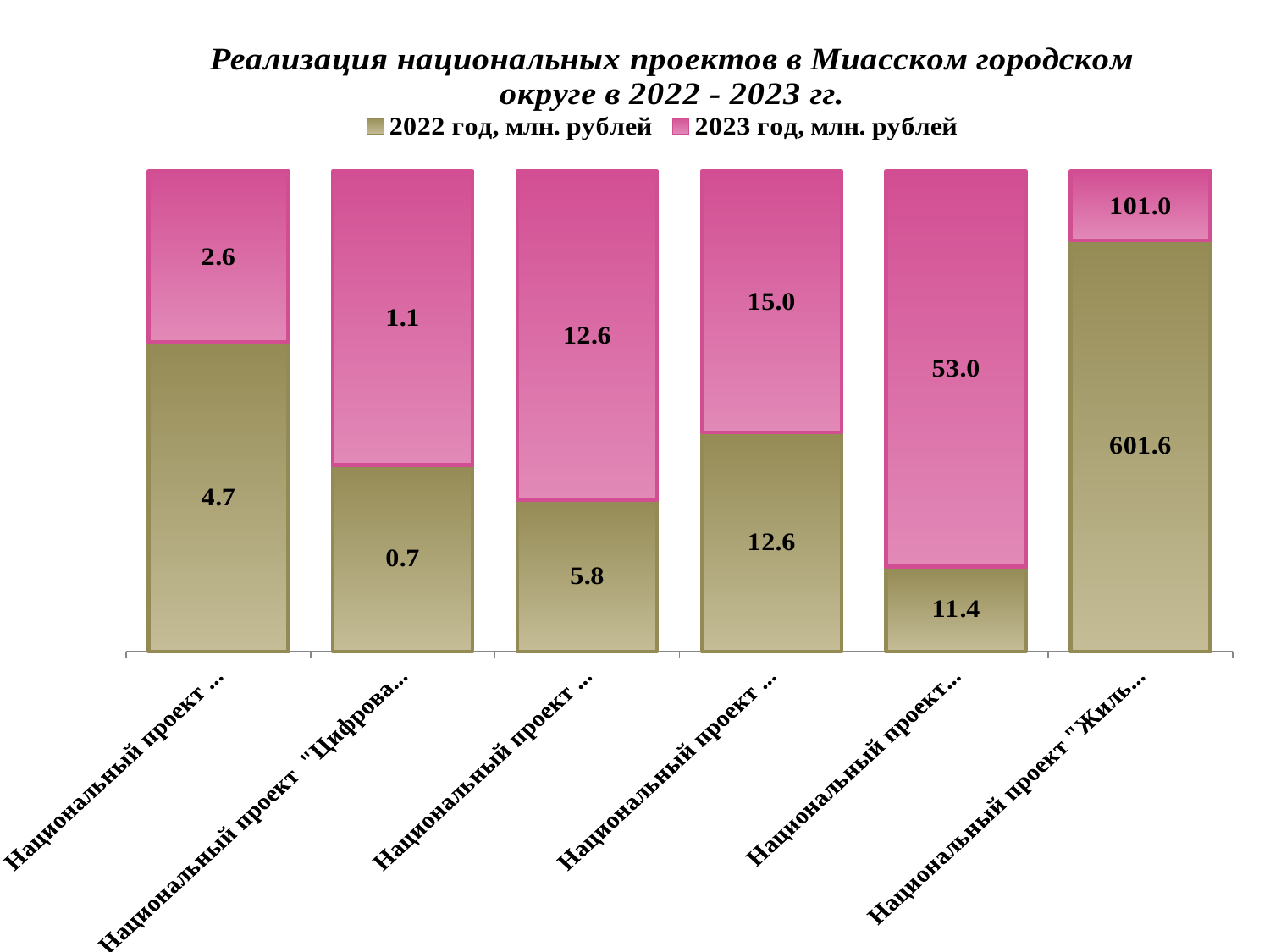
For the first (leftmost) bar, which is larger: the 2022 value or the 2023 value? 2022 (4.7) How many bars (categories) are shown in the chart? 6 What unit is given in the legend entries? млн. рублей What is the 2022 value for the third bar from the left? 5.8 What is the total of the 2022 and 2023 values for the first (leftmost) bar? 7.3 What kind of chart is shown on the slide? Stacked bar chart How many series does the legend list? 2 Which bar has the lowest 2022 value? The second bar from the left, 0.7 What is the difference between the 2023 and 2022 values for the fifth bar from the left? 41.6 What is the 2023 value for the fifth bar from the left? 53.0 Which bar has the highest 2022 value? The sixth (rightmost) bar, 601.6 What is the 2022 value for the sixth (rightmost) bar? 601.6